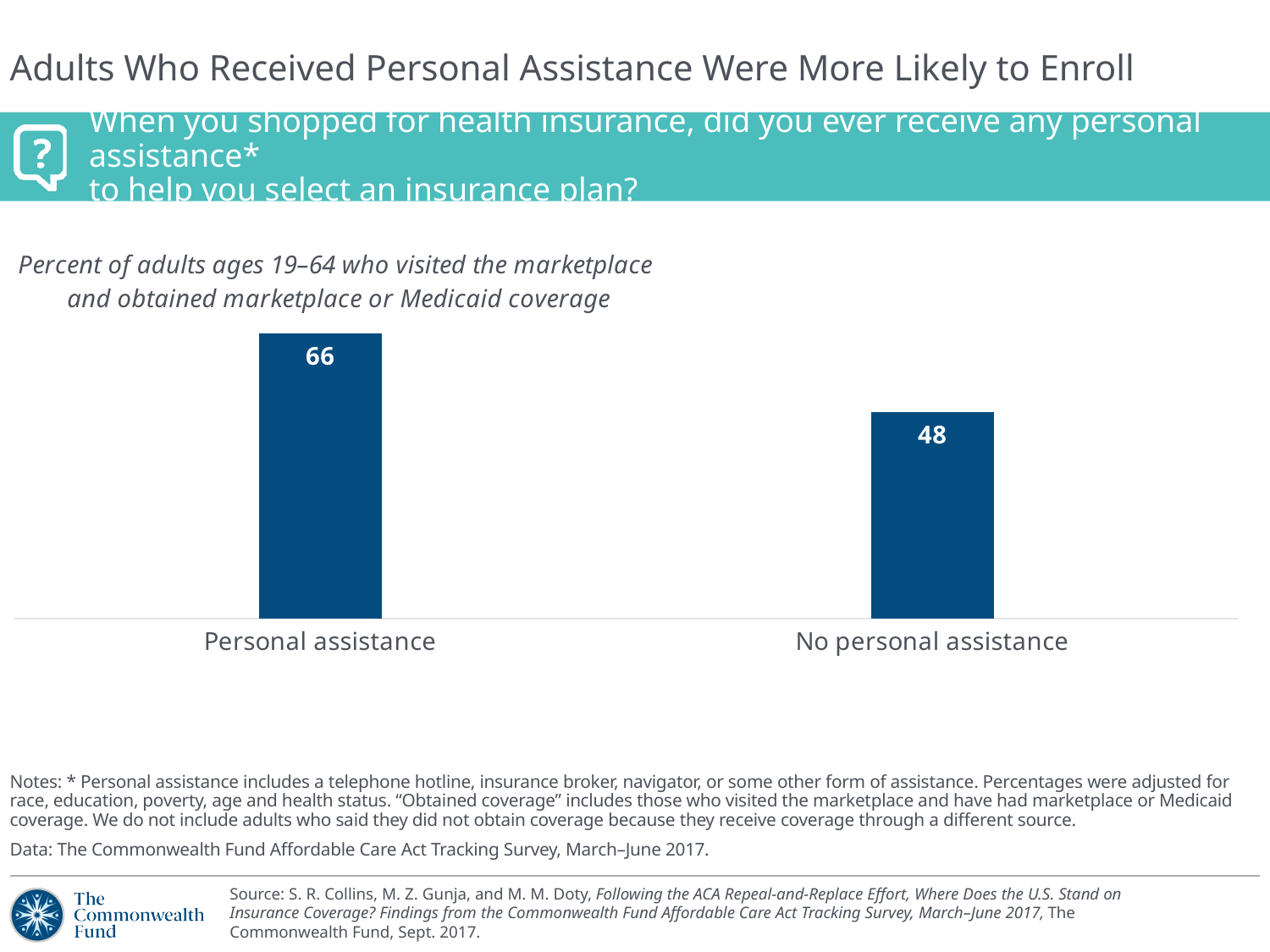
What is the value for Personal assistance? 66 What does the chart's subtitle say the values represent? Percent of adults ages 19–64 who visited the marketplace and obtained marketplace or Medicaid coverage Which is larger, the value for Personal assistance or the value for No personal assistance? Personal assistance What colour are the bars in the chart? Dark blue Which category has the lowest value? No personal assistance How many categories are shown in the chart? 2 What kind of chart is shown on the slide? Bar chart What is the difference between the values for Personal assistance and No personal assistance? 18 What is the value for No personal assistance? 48 Which category has the highest value? Personal assistance